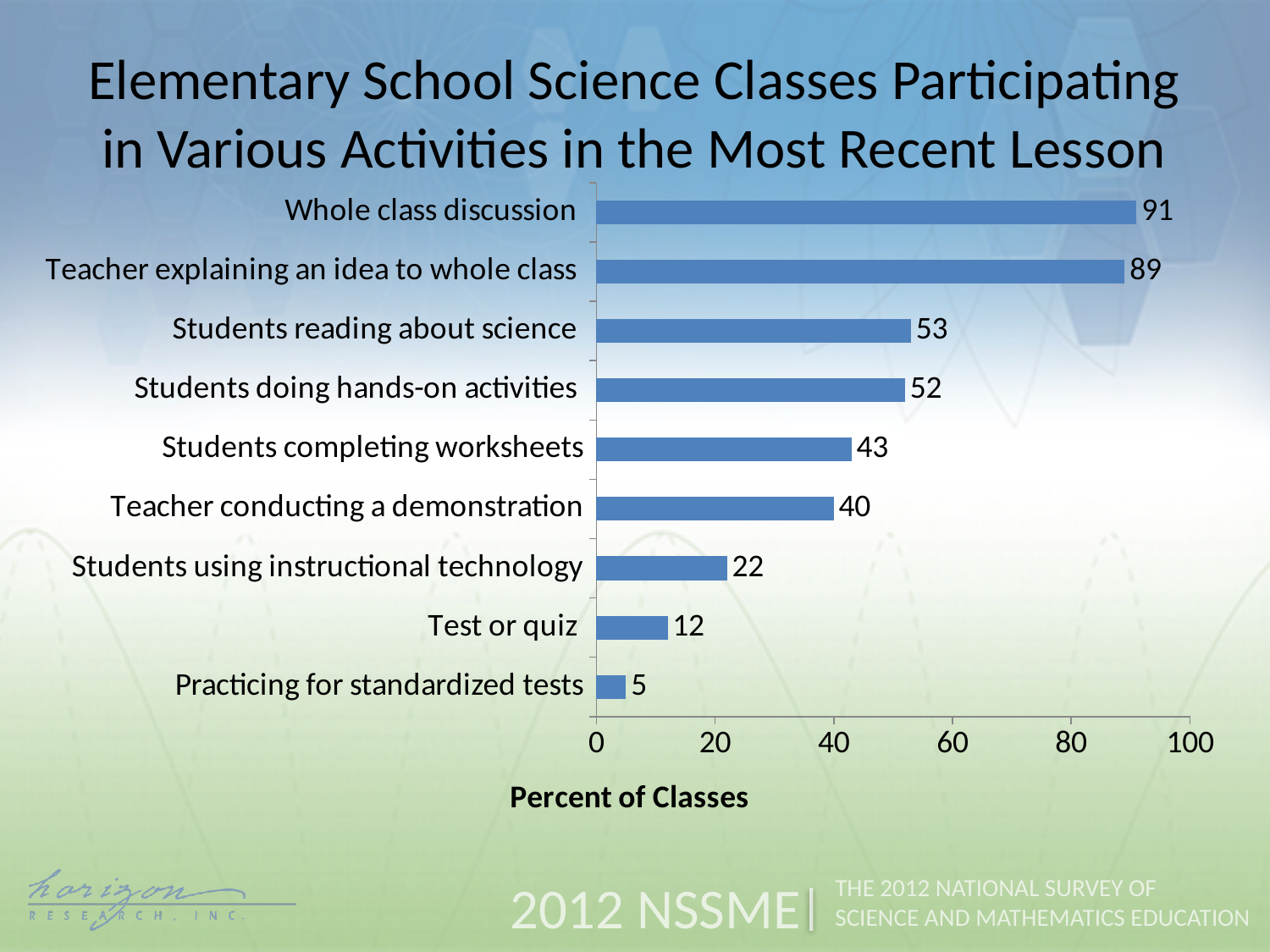
What is the value for Whole class discussion? 91 Is the value for Students reading about science greater or less than 40? greater How many activities are shown in the chart? 9 Which is larger, the value for Students completing worksheets or the value for Teacher conducting a demonstration? Students completing worksheets Which activity has the lowest percent of classes? Practicing for standardized tests What is the label of the horizontal axis? Percent of Classes What is the difference between the values for Whole class discussion and Teacher explaining an idea to whole class? 2 Which activity has the highest percent of classes? Whole class discussion What kind of chart is shown on the slide? bar chart What is the value for Test or quiz? 12 What is the difference between the values for Students using instructional technology and Test or quiz? 10 What is the value for Students completing worksheets? 43